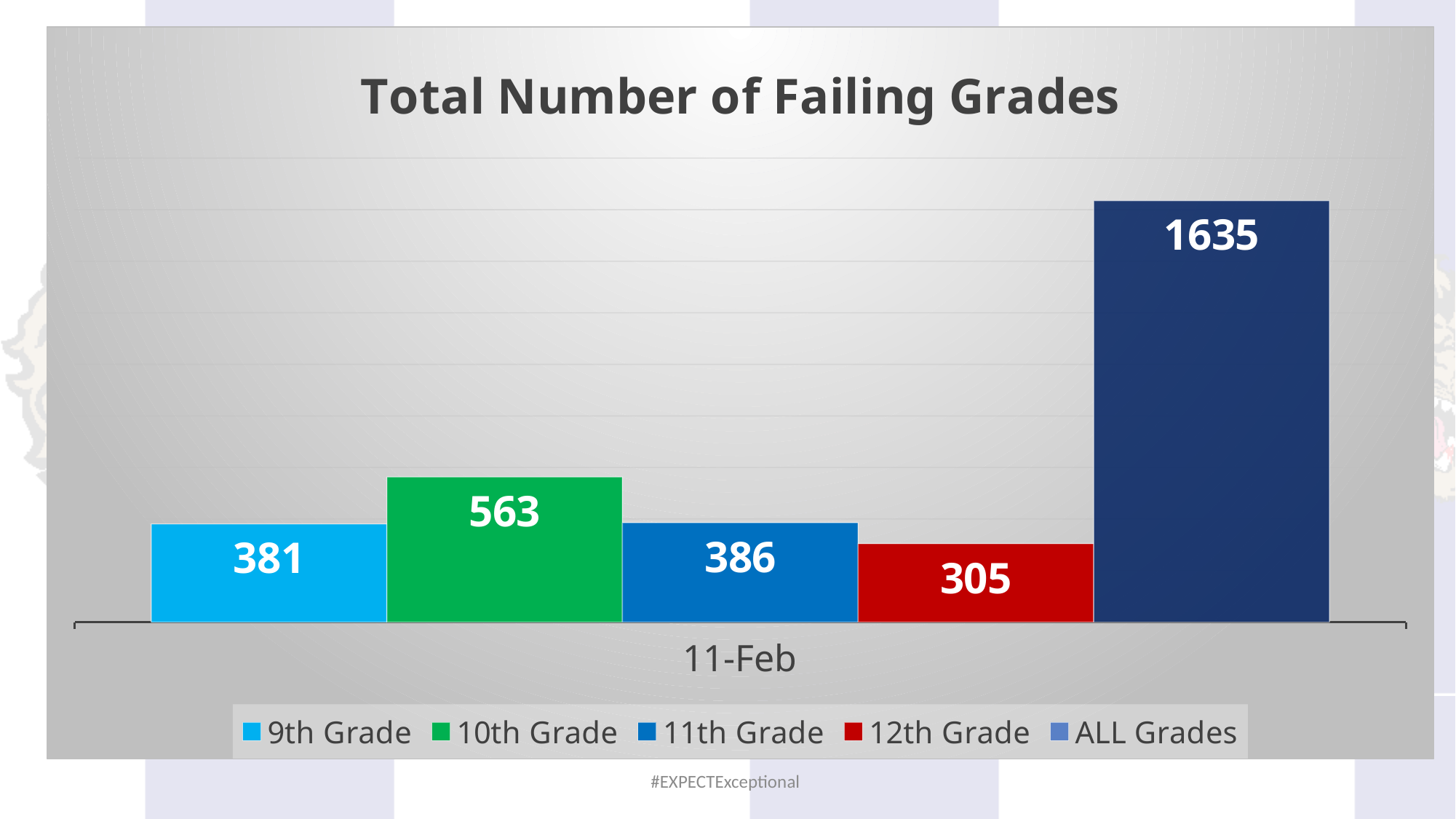
What kind of chart is shown? Bar chart What is the value for ALL Grades? 1635 What is the value for 9th Grade? 381 Which individual grade level has the highest number of failing grades? 10th Grade What is the value for 12th Grade? 305 What is the difference between the values for 10th Grade and 12th Grade? 258 How many series does the legend list? 5 Which is larger, the value for 9th Grade or the value for 11th Grade? 11th Grade What is the title of the chart? Total Number of Failing Grades What is the value for 10th Grade? 563 What is the value for 11th Grade? 386 Which series has the lowest value? 12th Grade